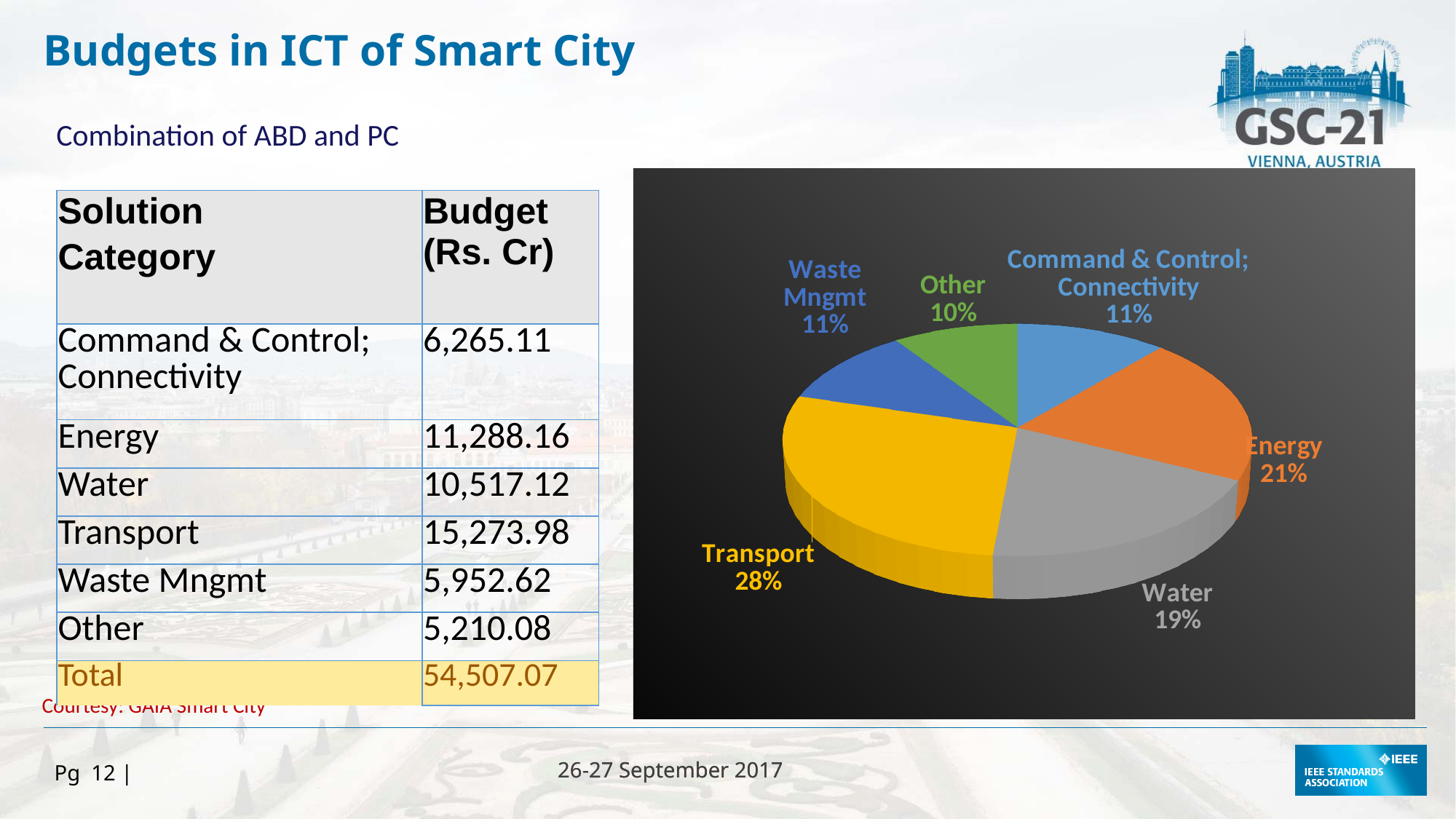
What kind of chart is shown on the slide? pie chart In the pie chart, which has the larger share, Energy or Water? Energy In the pie chart, what is the difference in percentage points between the Transport share and the Water share? 9 What share of the pie chart does Waste Mngmt account for? 11% Which category has the largest slice in the pie chart? Transport How many slices does the pie chart have? 6 What share of the pie chart does Energy account for? 21% What share of the pie chart does Water account for? 19% Which category has the smallest slice in the pie chart? Other What colour is the Transport slice in the pie chart? yellow